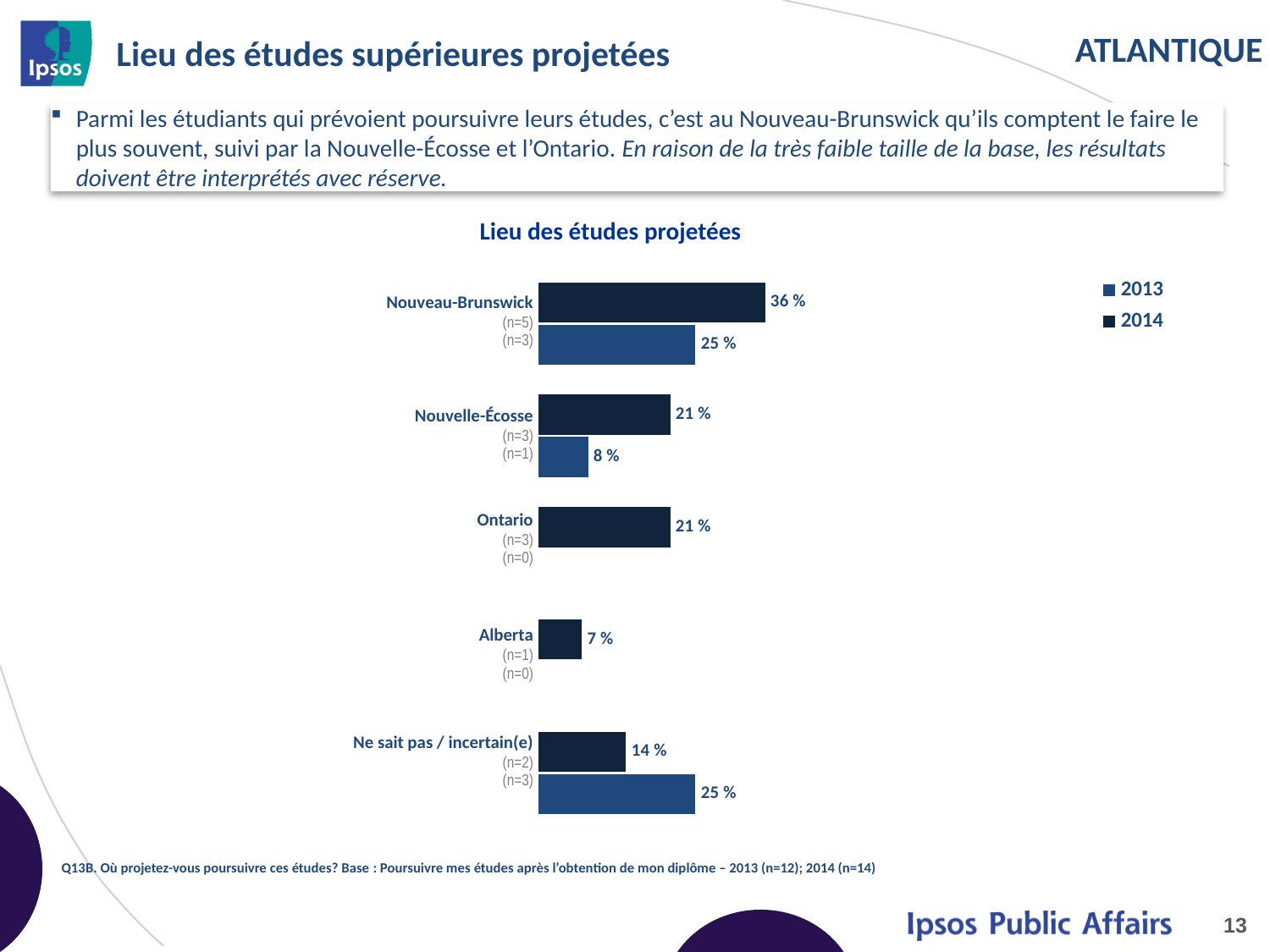
What is the 2013 value for Ne sait pas / incertain(e)? 25 % What is the difference between the 2013 and 2014 values for Nouveau-Brunswick? 11 % What is the 2014 value for Nouvelle-Écosse? 21 % What is the title of the chart? Lieu des études projetées How many series does the legend list? 2 How many categories are shown on the chart? 5 Which is larger for Ne sait pas / incertain(e): the 2013 value or the 2014 value? 2013 What is the 2013 value for Nouveau-Brunswick? 25 % What kind of chart is shown on the slide? Bar chart